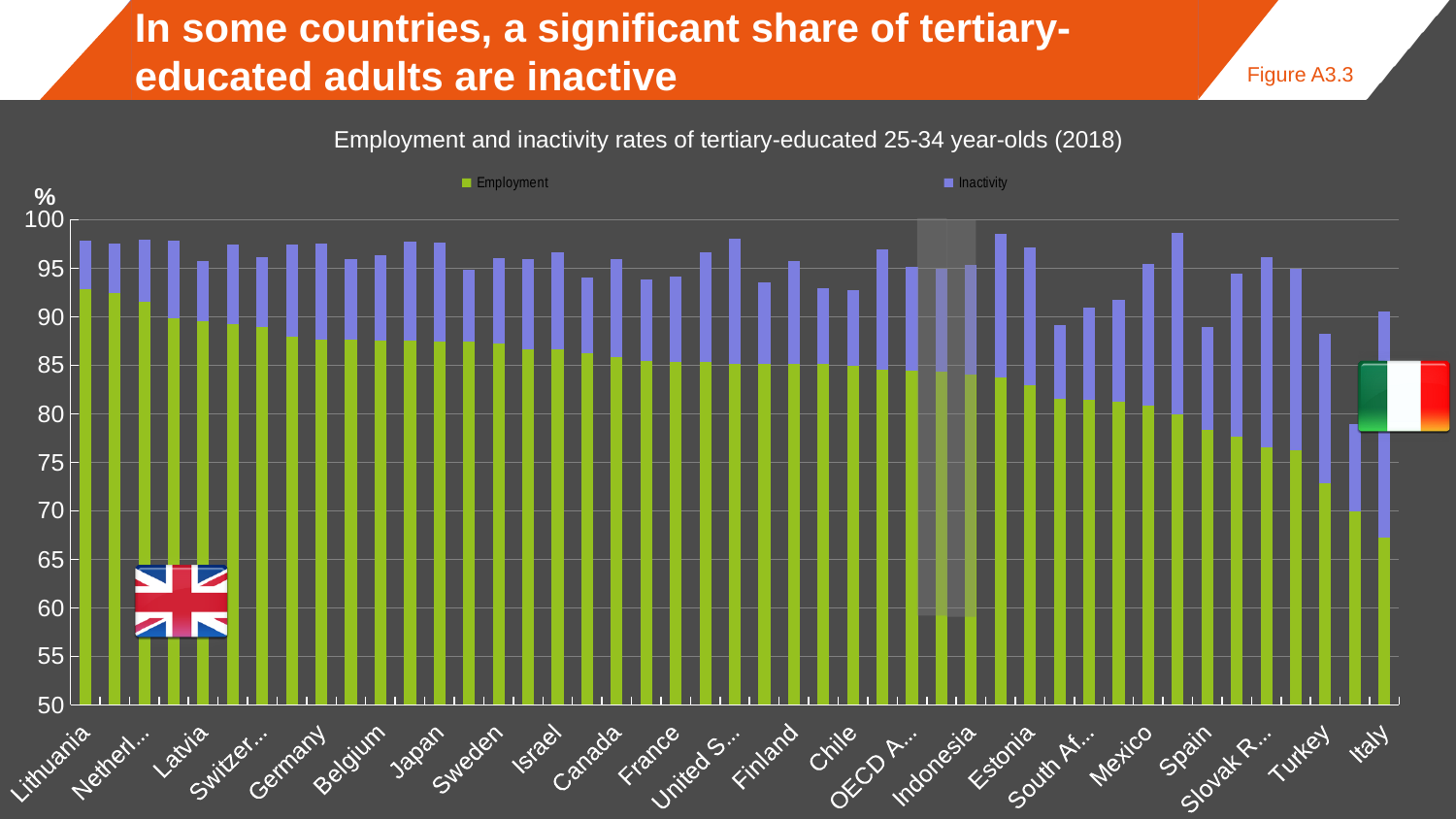
Which has the larger Employment value, Lithuania or Italy? Lithuania Is the Employment value for Chile greater or less than 90? less Is the Employment value for Turkey greater or less than 75? less What is the title of the chart? Employment and inactivity rates of tertiary-educated 25-34 year-olds (2018) Do the Employment values generally rise or fall from left to right along the x axis? fall Is the Employment value for Lithuania greater or less than 90? greater How many series does the legend list? 2 What are the two series named in the legend? Employment and Inactivity What kind of chart is shown on the slide? Stacked bar chart